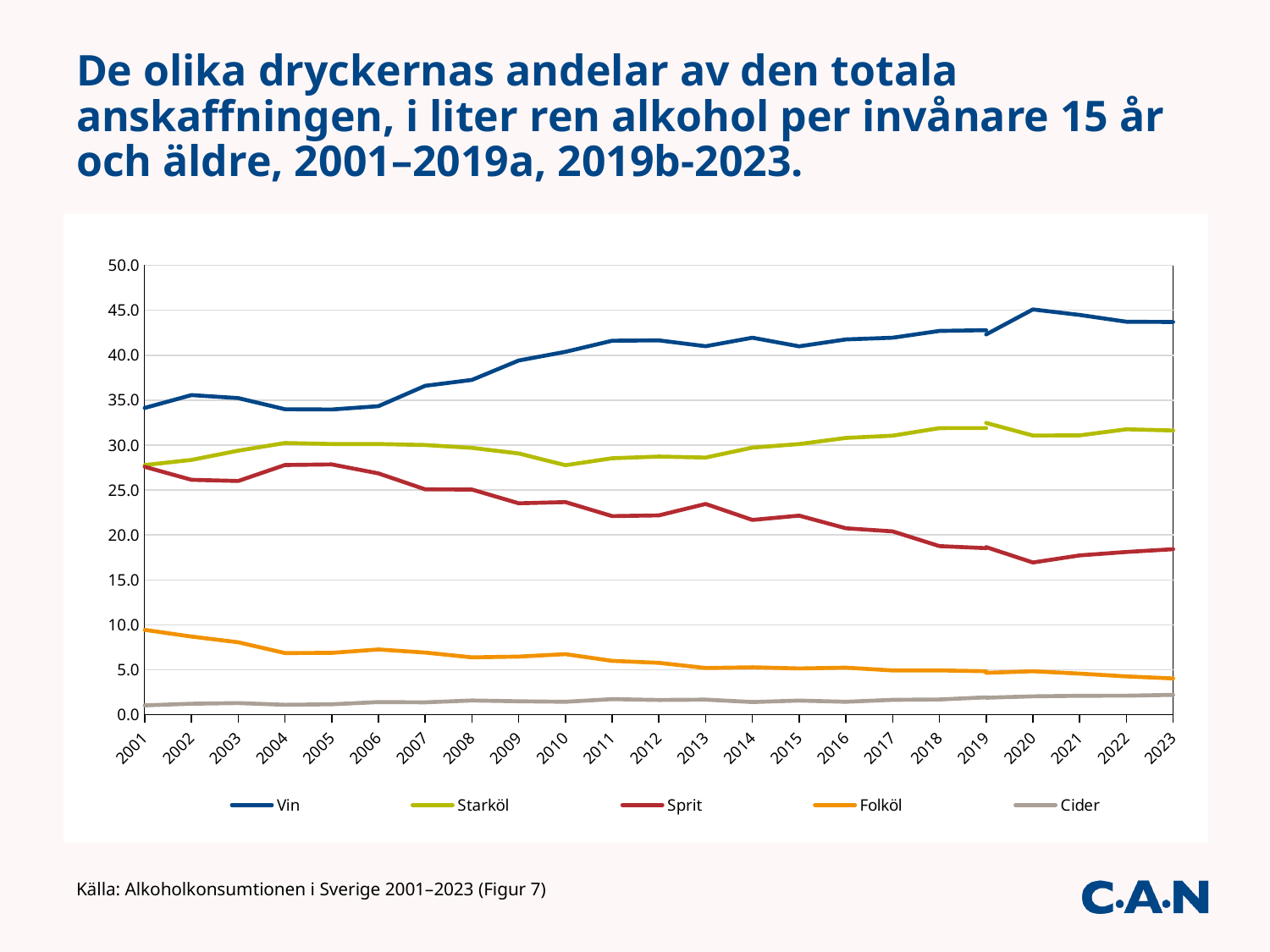
Is the value for Folköl in 2001 greater or less than 5.0? greater Is the value for Starköl in 2010 greater or less than 30.0? less What kind of chart is shown on the slide? line chart Which series is drawn in orange? Folköl Which is larger in 2023, Starköl or Sprit? Starköl Is the value for Vin in 2020 greater or less than 40.0? greater How many series does the legend list? 5 Which series has the lowest value in 2023? Cider Does the value for Sprit rise or fall from 2001 to 2023? fall Which series has the highest value in 2023? Vin How many years are shown along the x axis? 23